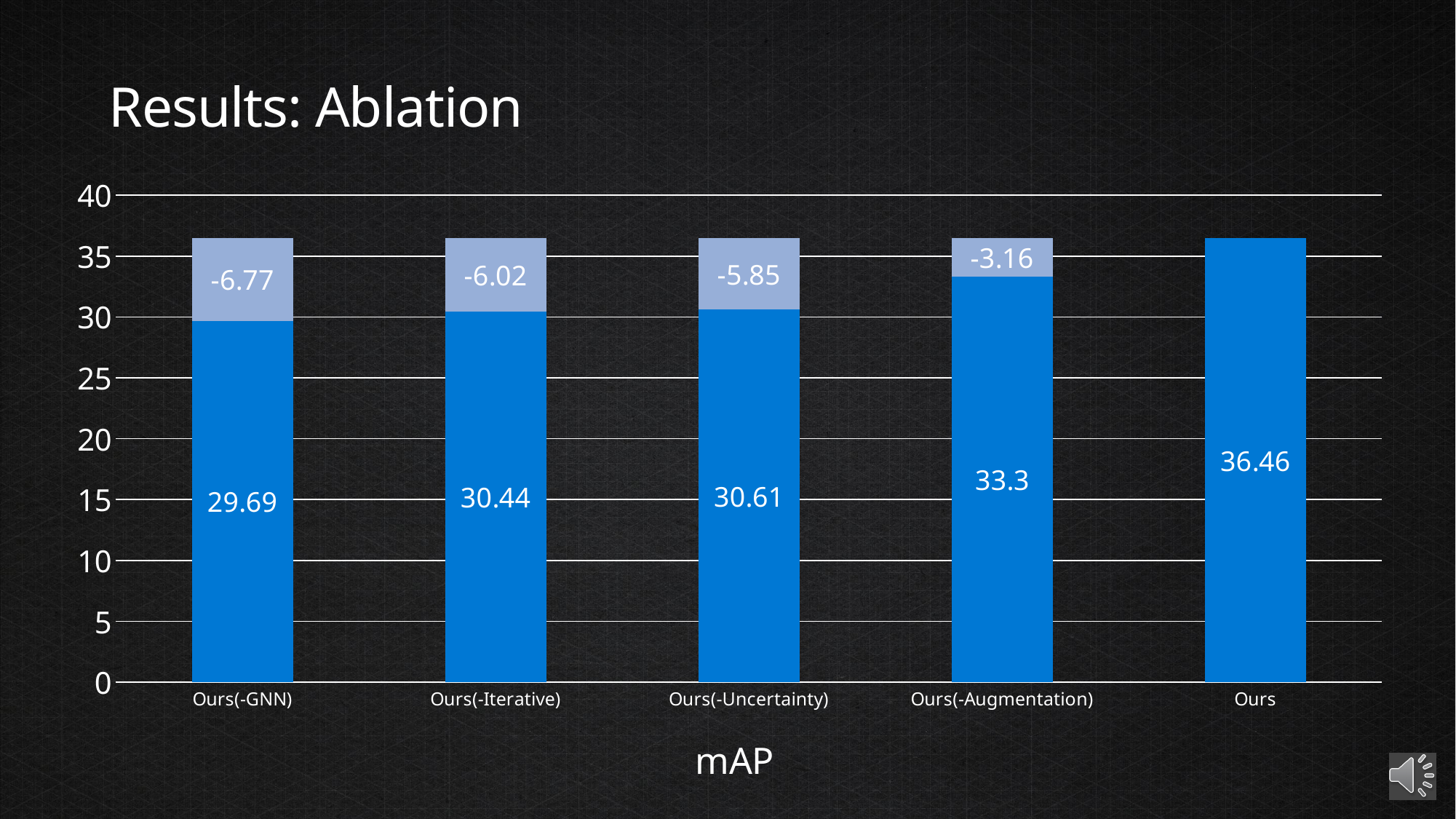
What is the mAP value for Ours(-GNN)? 29.69 What is the mAP value for Ours(-Uncertainty)? 30.61 What drop in mAP is labelled on the lighter segment above Ours(-GNN)? -6.77 What is the mAP value for Ours(-Augmentation)? 33.3 What drop in mAP is labelled on the lighter segment above Ours(-Augmentation)? -3.16 How many categories are shown on the x axis? 5 Which category has the lowest mAP? Ours(-GNN) Which category has the highest mAP? Ours What kind of chart is shown on the slide? Bar chart What is the mAP value for Ours? 36.46 What is the difference in mAP between Ours and Ours(-Augmentation)? 3.16 What is the mAP value for Ours(-Iterative)? 30.44